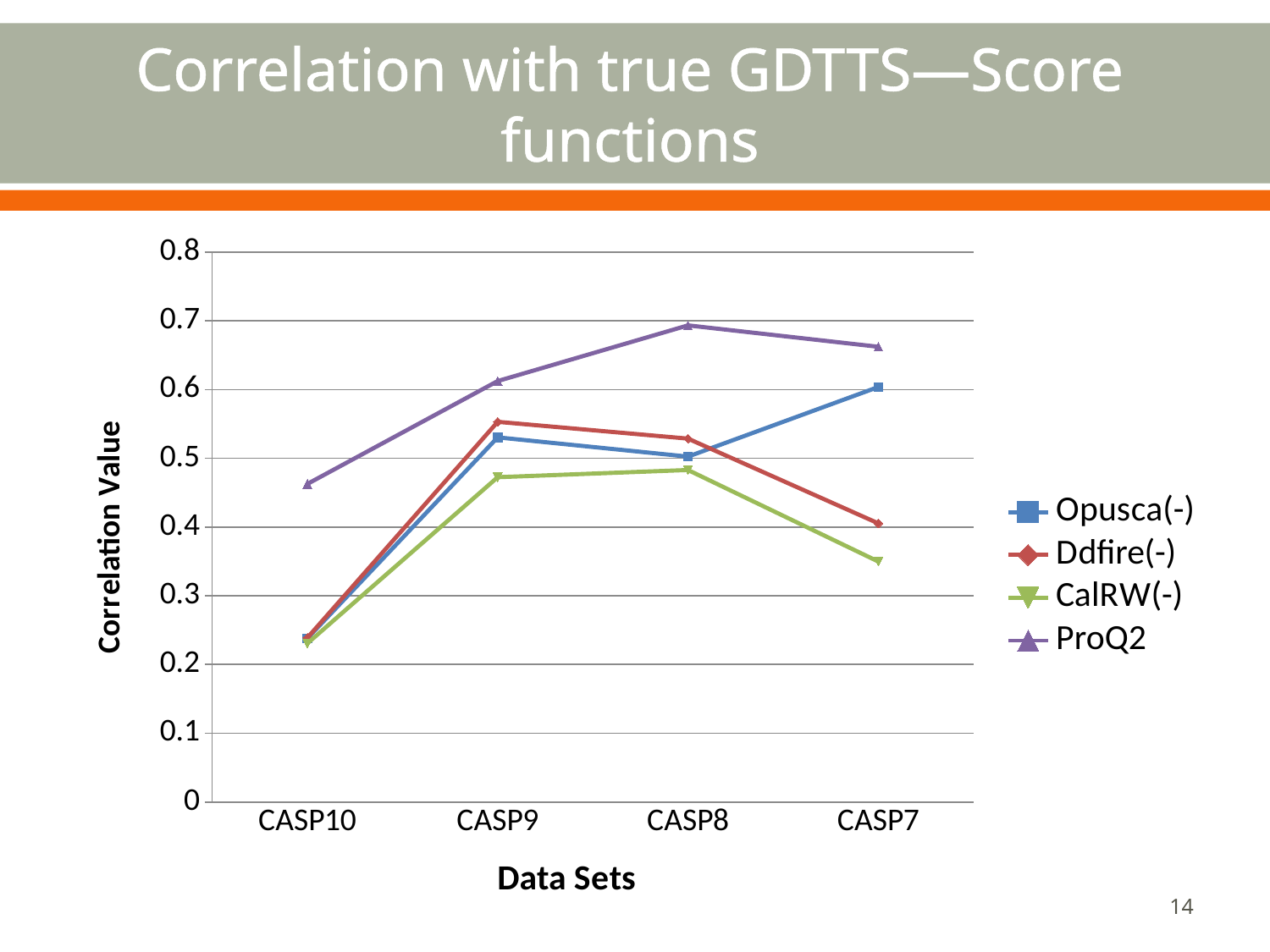
At CASP7, which is larger: Opusca(-) or Ddfire(-)? Opusca(-) Is the value for Opusca(-) at CASP7 greater or less than 0.5? greater What kind of chart is shown on the slide? line chart Does the ProQ2 line rise or fall from CASP10 to CASP8? rise Which series has the lowest correlation value at CASP7? CalRW(-) Is the value for ProQ2 at CASP10 greater or less than 0.4? greater What is the title of the y axis? Correlation Value Is the value for CalRW(-) at CASP7 greater or less than 0.4? less For ProQ2, which data set has the highest correlation value? CASP8 How many series does the legend list? 4 How many data sets are shown along the x axis? 4 Which series has the highest correlation value at CASP8? ProQ2